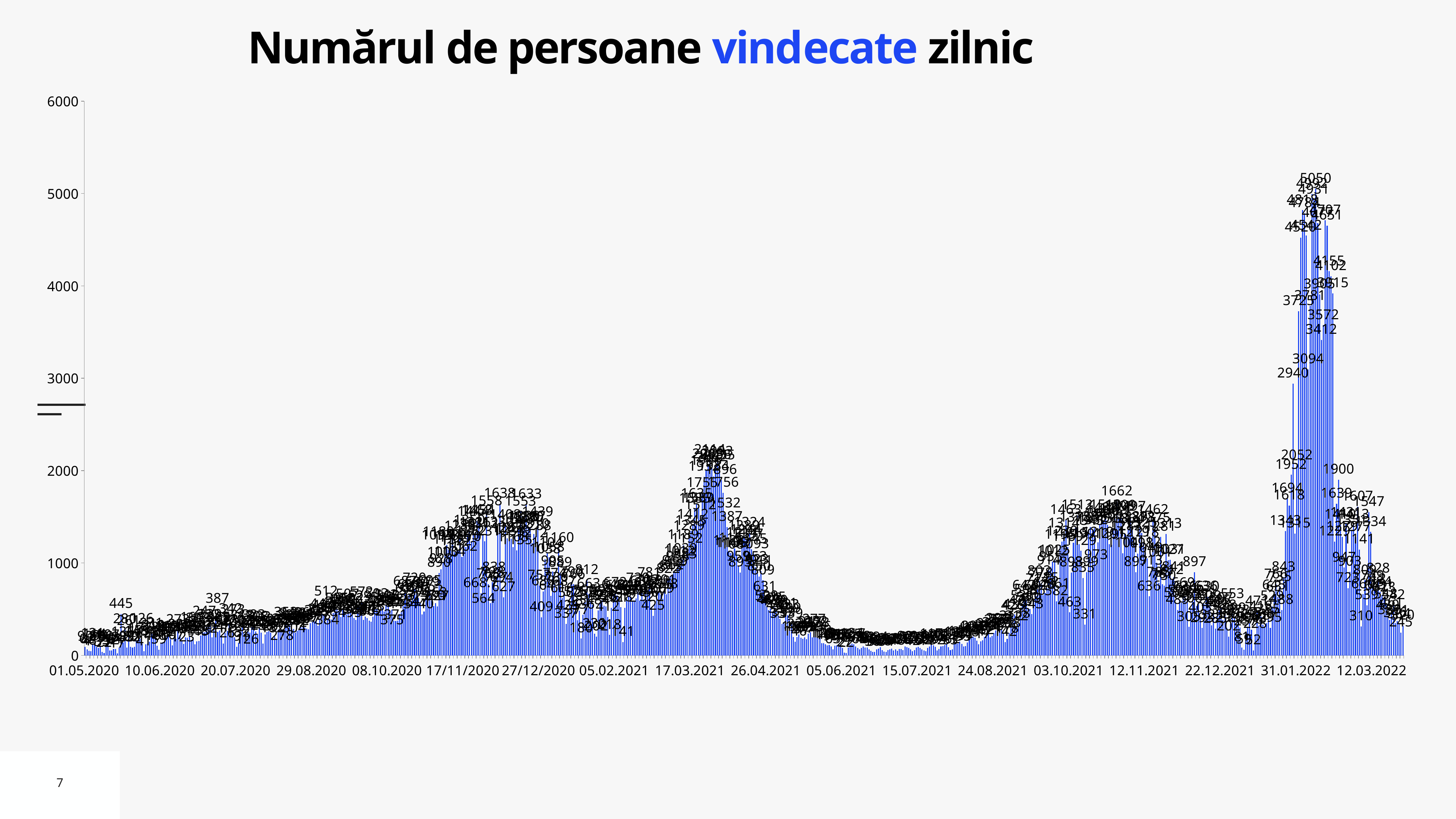
Which peak is higher: the one around 17.03.2021 or the one between 31.01.2022 and 12.03.2022? the one between 31.01.2022 and 12.03.2022 What is the title of the chart? Numărul de persoane vindecate zilnic What is the highest data label value shown on the chart? 5050 Is the value at 01.05.2020 greater or less than 1000? less Is the value around 31.01.2022 greater or less than 1000? greater What is the highest labeled value in the peak around 12.11.2021? 1662 Is the value around 15.07.2021 greater or less than 1000? less Do the values rise or fall between 24.08.2021 and 03.10.2021? rise What kind of chart is shown on the slide? bar chart What is the last date shown on the x axis? 12.03.2022